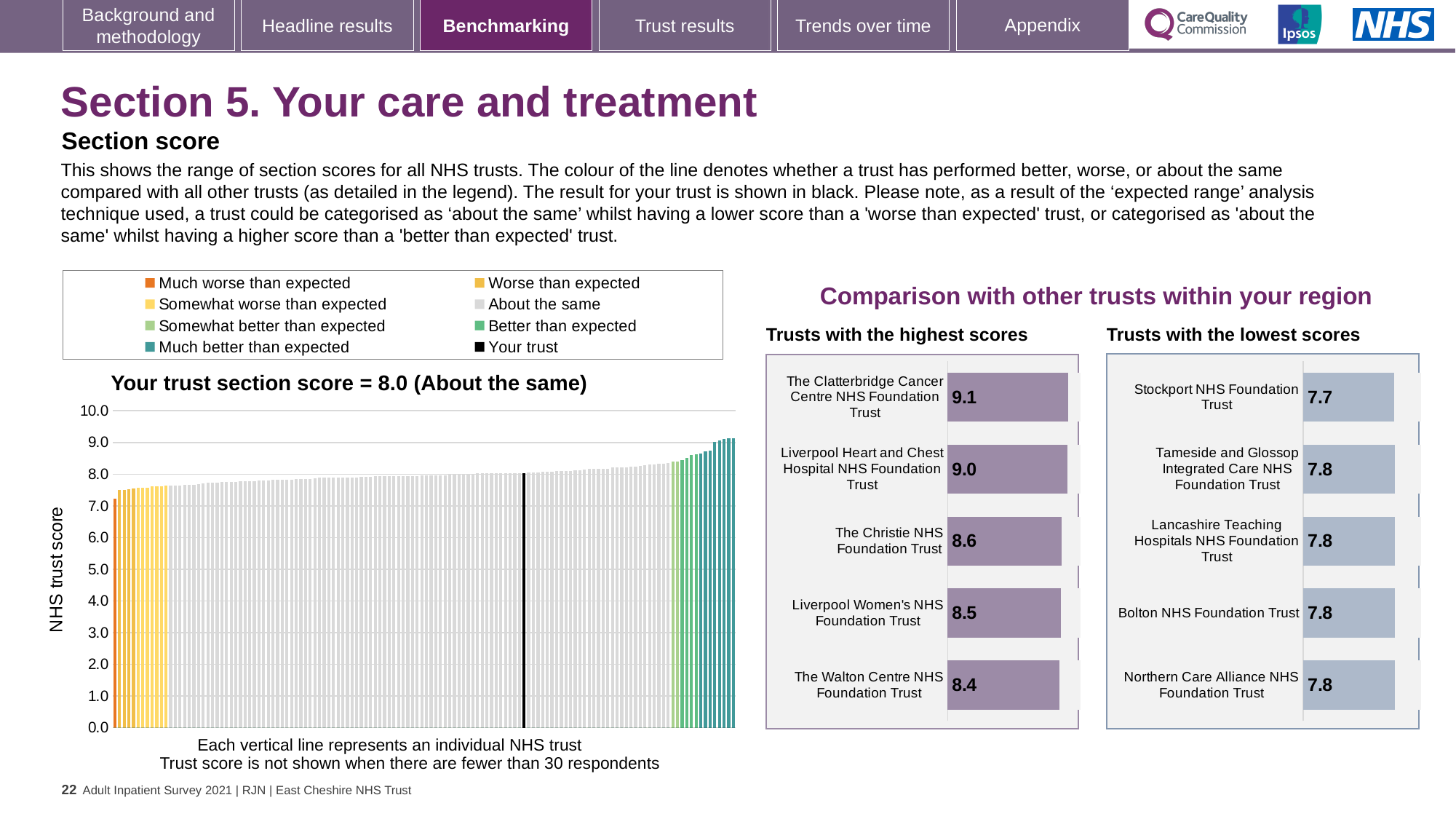
In the 'Your trust section score' chart, do the trust scores rise or fall from left to right along the x axis? rise In the 'Trusts with the lowest scores' chart, how many trusts are listed? 5 In the 'Trusts with the lowest scores' chart, what is the score for Stockport NHS Foundation Trust? 7.7 How many entries does the legend above the 'Your trust section score' chart list? 8 In the 'Trusts with the highest scores' chart, which has the larger score: Liverpool Heart and Chest Hospital NHS Foundation Trust or Liverpool Women's NHS Foundation Trust? Liverpool Heart and Chest Hospital NHS Foundation Trust In the 'Trusts with the highest scores' chart, which trust has the highest score? The Clatterbridge Cancer Centre NHS Foundation Trust In the 'Your trust section score' chart, is the value of the leftmost (orange) bar greater or less than 8.0? less In the 'Your trust section score' chart, what is the section score for your trust? 8.0 In the 'Trusts with the highest scores' chart, which trust has the lowest score? The Walton Centre NHS Foundation Trust In the 'Trusts with the highest scores' chart, what is the score for The Christie NHS Foundation Trust? 8.6 In the 'Trusts with the highest scores' chart, what is the difference between the scores of The Clatterbridge Cancer Centre NHS Foundation Trust and The Walton Centre NHS Foundation Trust? 0.7 In the 'Trusts with the lowest scores' chart, what is the score for Bolton NHS Foundation Trust? 7.8